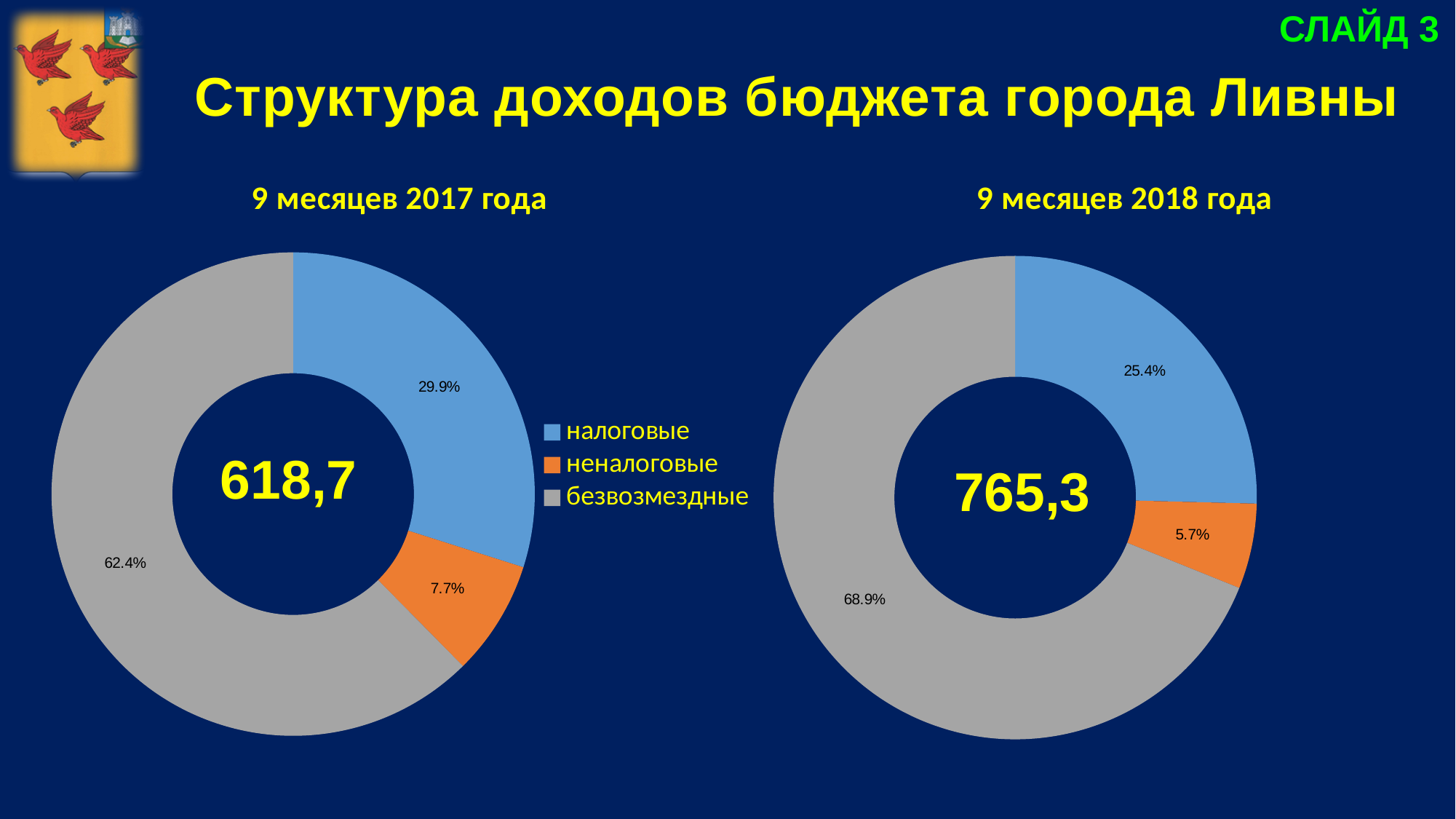
What total value is shown in the centre of the '9 месяцев 2018 года' chart? 765,3 Which colour represents безвозмездные in the legend? grey In the '9 месяцев 2018 года' chart, what share is labelled for безвозмездные? 68.9% In the '9 месяцев 2017 года' chart, what is the difference in percentage points between безвозмездные and налоговые? 32.5 In the '9 месяцев 2017 года' chart, what share is labelled for налоговые? 29.9% How many categories does each doughnut chart show? 3 In the '9 месяцев 2017 года' chart, what share is labelled for неналоговые? 7.7% In the '9 месяцев 2018 года' chart, what share is labelled for неналоговые? 5.7% In the '9 месяцев 2018 года' chart, which category has the smallest share? неналоговые Which is larger: the share of налоговые in the '9 месяцев 2017 года' chart or in the '9 месяцев 2018 года' chart? 9 месяцев 2017 года What type of chart is used on this slide? doughnut chart In the '9 месяцев 2017 года' chart, which category has the largest share? безвозмездные